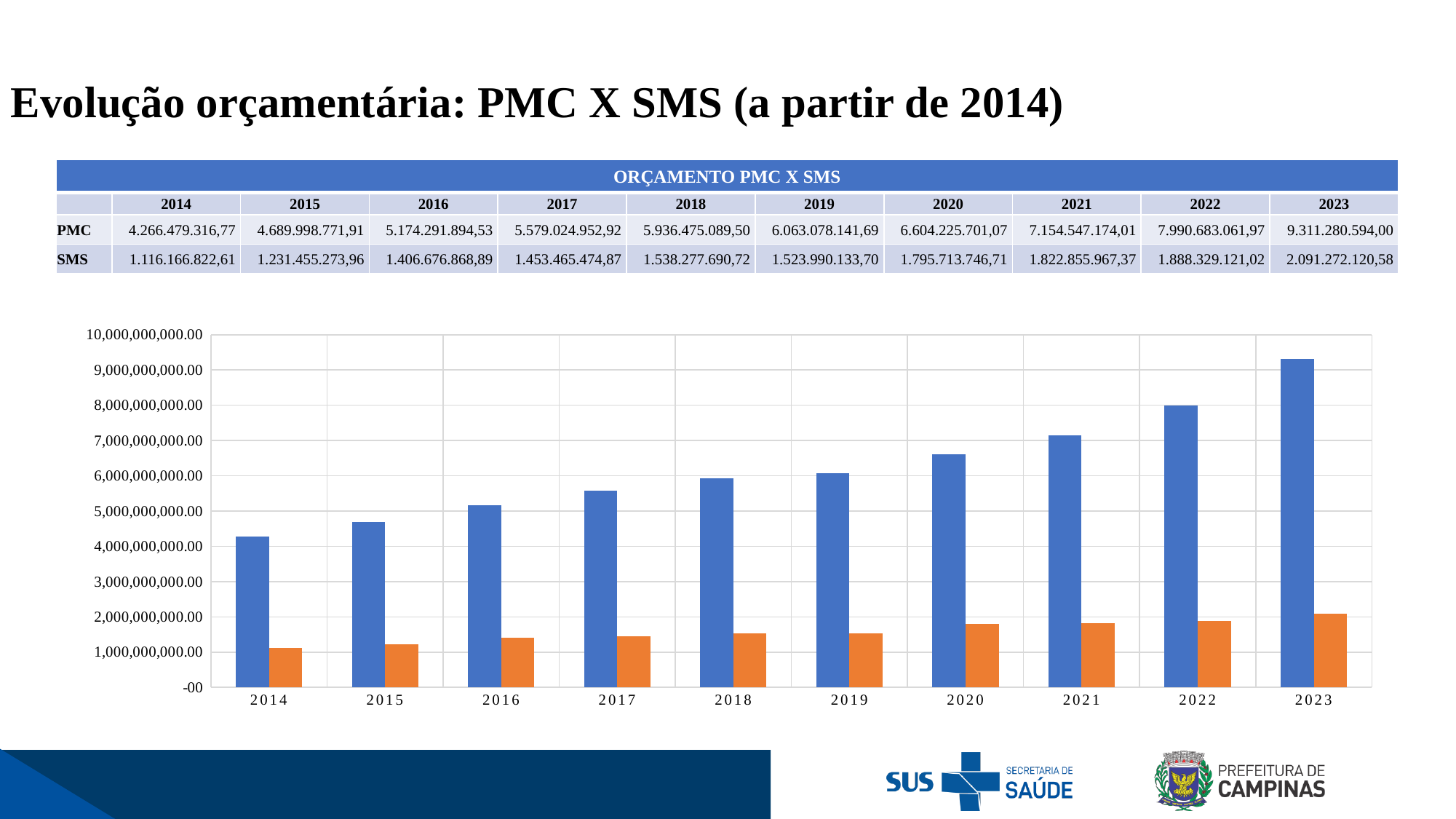
Is the PMC value for 2020 greater or less than 6,000,000,000.00? greater What is the difference between the PMC values for 2023 and 2022? 1.320.597.532,03 What is the SMS budget value for 2020? 1.795.713.746,71 What is the PMC budget value for 2023? 9.311.280.594,00 Do the PMC values rise or fall from 2014 to 2023? rise In which year is the SMS budget lowest? 2014 Which is larger: the PMC value for 2014 or the SMS value for 2023? PMC value for 2014 What is the SMS budget value for 2014? 1.116.166.822,61 In which year is the PMC budget highest? 2023 What kind of chart is shown on the slide? bar chart How many years are shown along the x axis of the chart? 10 Is the SMS value for 2019 greater or less than 2,000,000,000.00? less